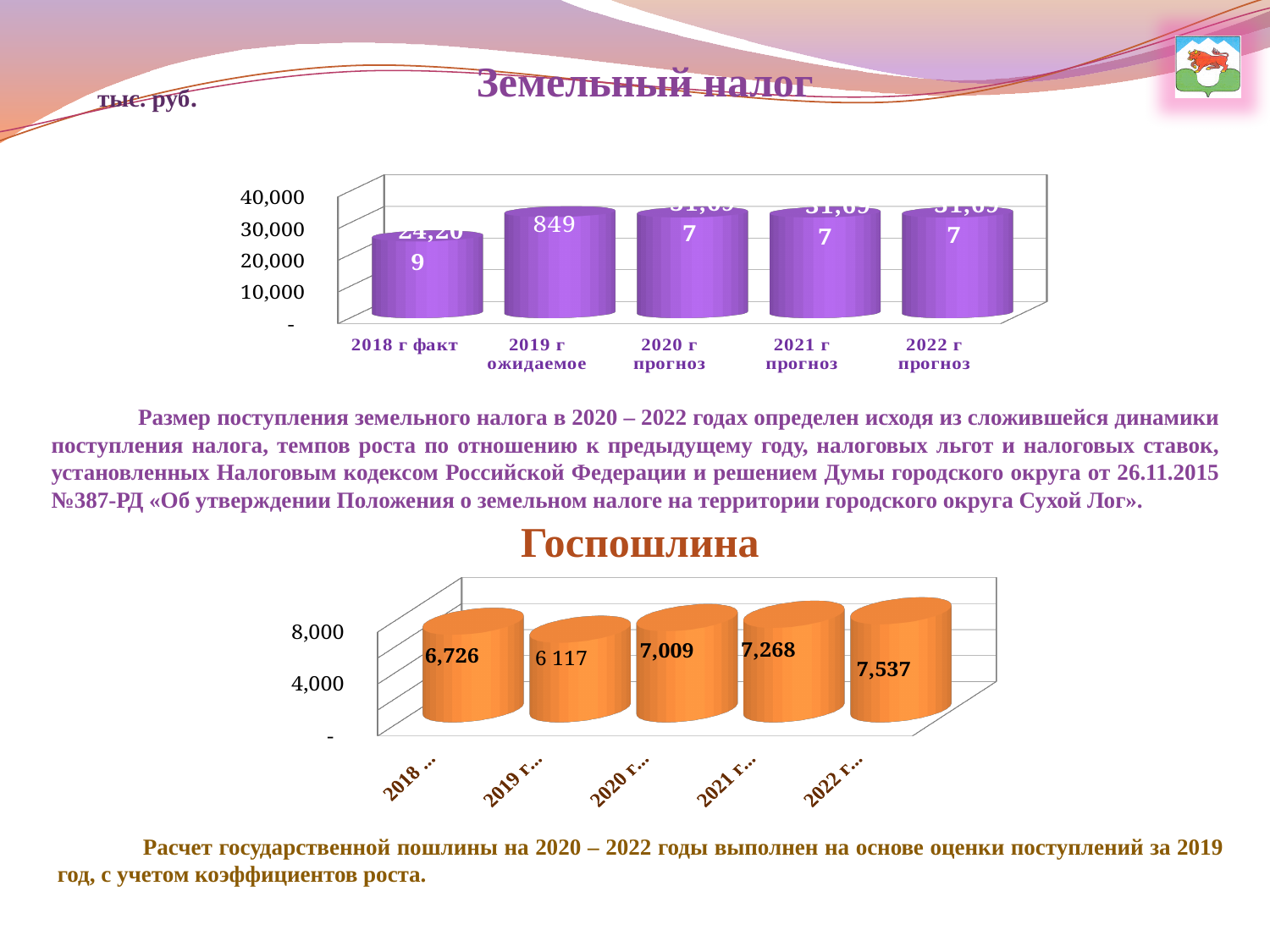
In the Госпошлина chart, what is the value for 2020? 7,009 In the Госпошлина chart, what is the difference between the values for 2022 and 2018? 811 What kind of chart is the Госпошлина chart? bar chart In the Госпошлина chart, what is the value for 2022? 7,537 In the Земельный налог chart, which category has the lowest value? 2018 г факт In the Госпошлина chart, which year has the highest value? 2022 How many categories are shown in the Земельный налог chart? 5 In the Земельный налог chart, is the value for 2018 г факт greater or less than 30,000? less In the Госпошлина chart, which year has the lowest value? 2019 In the Госпошлина chart, what is the value for 2019? 6 117 In the Госпошлина chart, do the values rise or fall from 2019 to 2022? rise In the Госпошлина chart, which is larger, the value for 2020 or the value for 2021? 2021